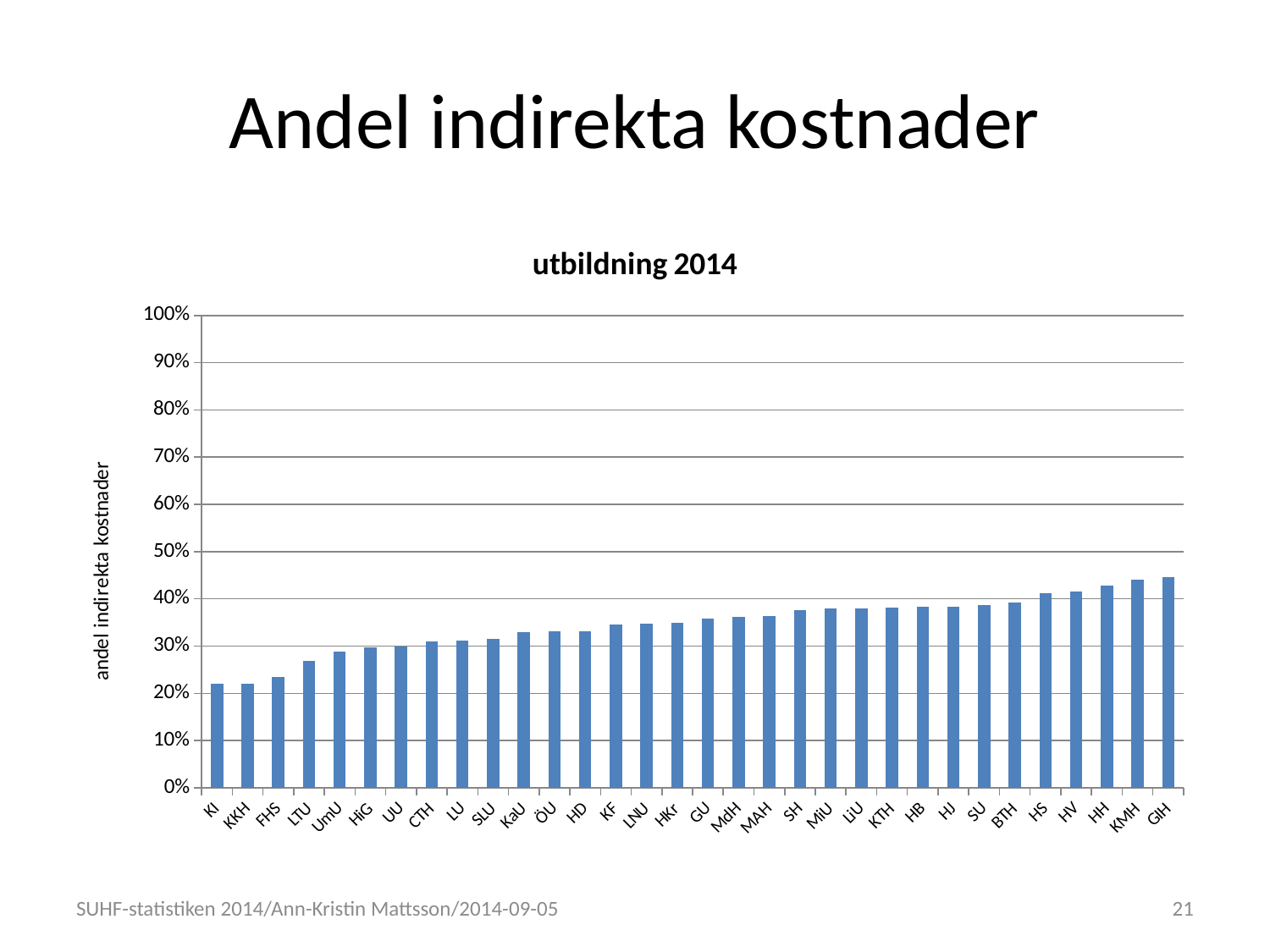
What is the label on the vertical axis of the chart? andel indirekta kostnader Is the value for KI greater or less than 30%? less Is the value for HH greater or less than 40%? greater Is the value for GIH greater or less than 40%? greater Do the values generally rise or fall from left to right along the x axis? rise What is the title of the chart? utbildning 2014 What kind of chart is shown on the slide? bar chart How many categories (bars) are shown in the chart? 32 Which has the larger value, LTU or HH? HH Which has the larger value, GIH or KI? GIH